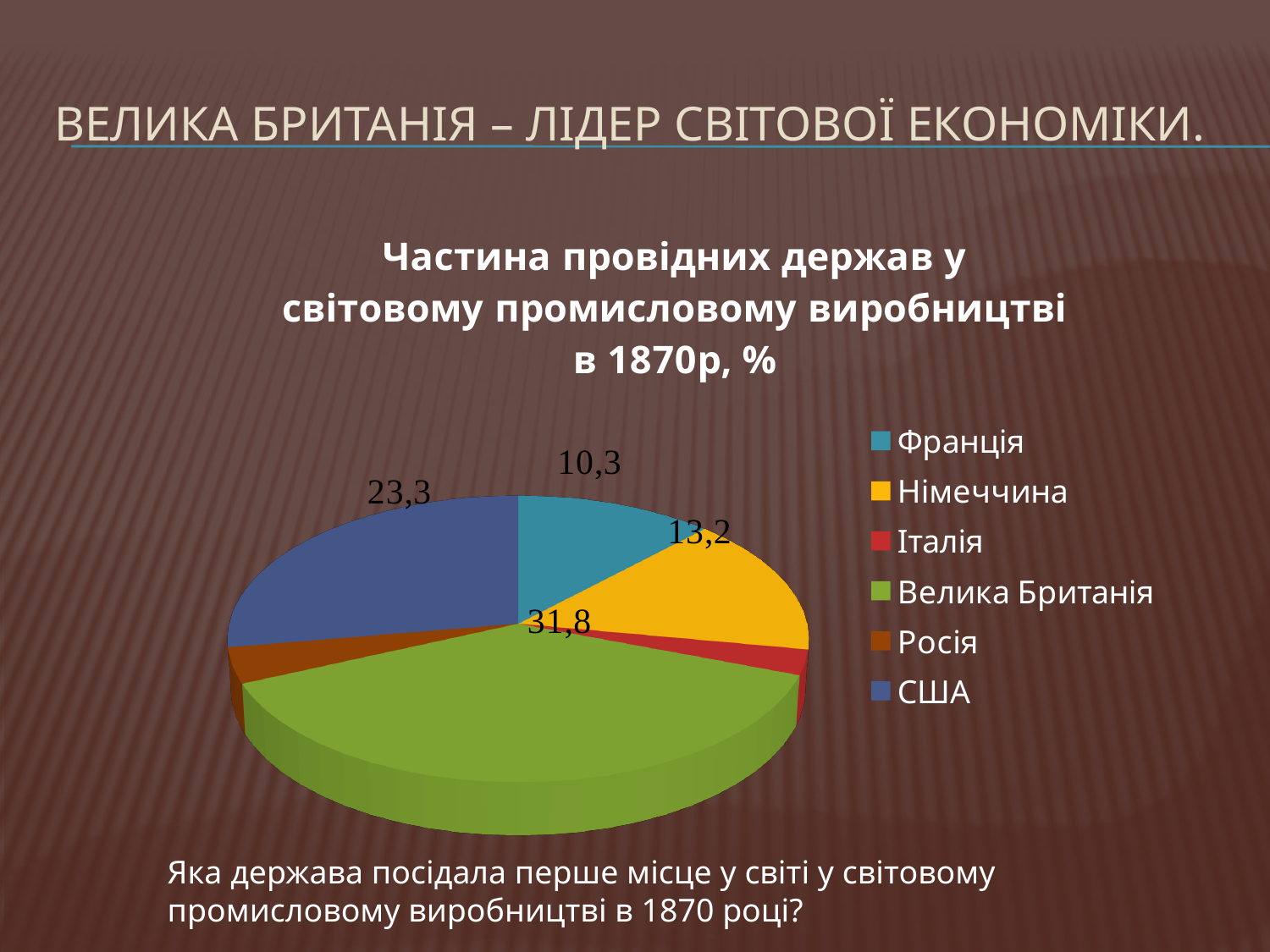
What is the difference between the values for Німеччина and Франція? 2,9 How many countries are listed in the legend? 6 What is the value shown for США? 23,3 Which is larger, the value for США or the value for Німеччина? США What is the difference between the values for Велика Британія and США? 8,5 What is the value shown for Велика Британія? 31,8 Which country has the largest slice of the pie? Велика Британія What is the value shown for Франція? 10,3 What year does the chart title refer to? 1870 Which country is represented by the green slice? Велика Британія What kind of chart is shown on the slide? Pie chart What is the value shown for Німеччина? 13,2